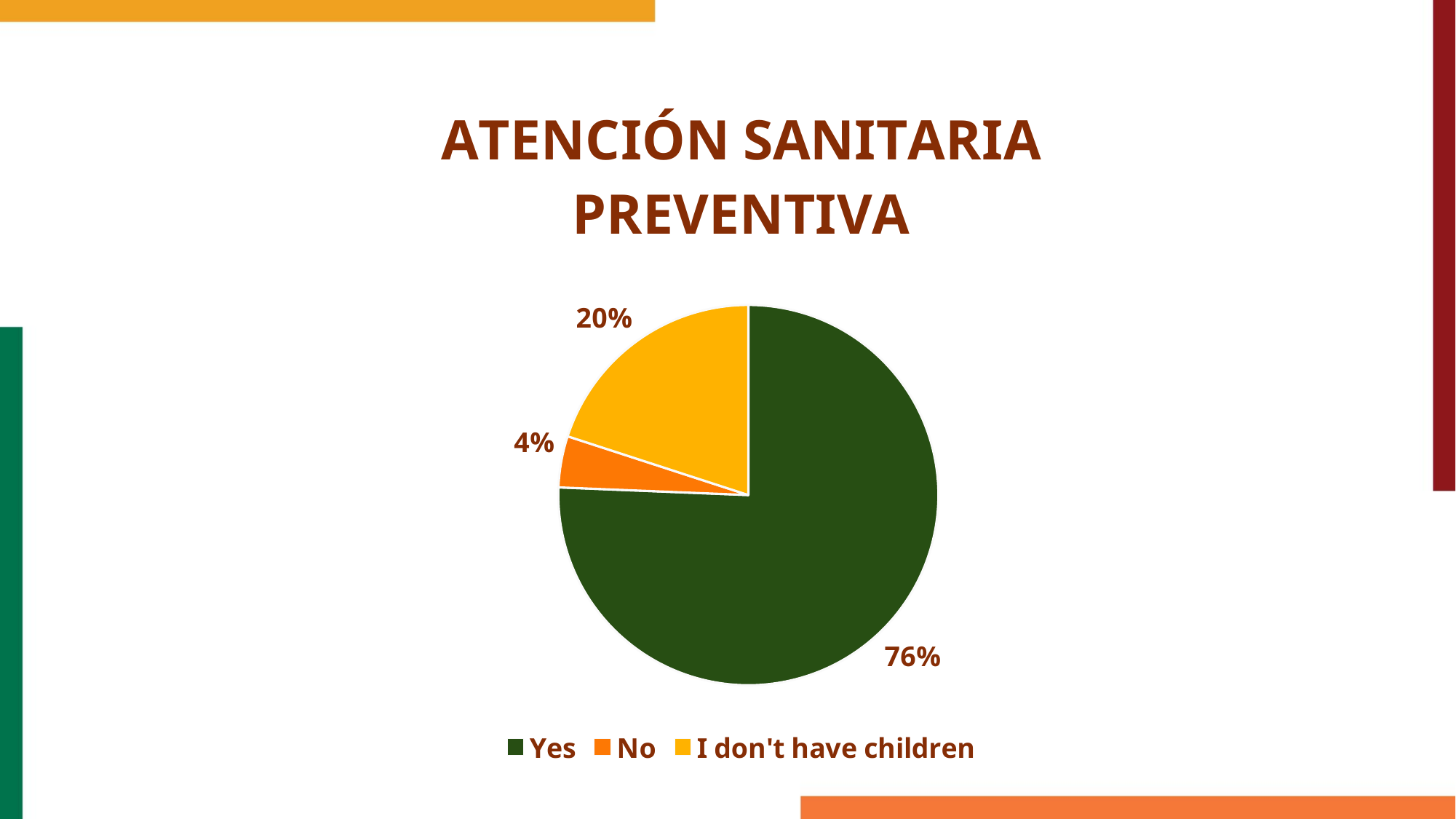
Which is larger, the "No" slice or the "I don't have children" slice? I don't have children How many categories does the pie chart show? 3 Which category has the smallest share of the pie? No What colour is the "Yes" slice in the pie chart? dark green What kind of chart is shown on the slide? pie chart What percentage of the pie is the "I don't have children" slice? 20% What is the combined share of the "No" and "I don't have children" slices? 24% What percentage of the pie is the "Yes" slice? 76% What percentage of the pie is the "No" slice? 4% Which category has the largest share of the pie? Yes What is the difference in percentage points between the "Yes" slice and the "I don't have children" slice? 56 What is the title of the chart? ATENCIÓN SANITARIA PREVENTIVA